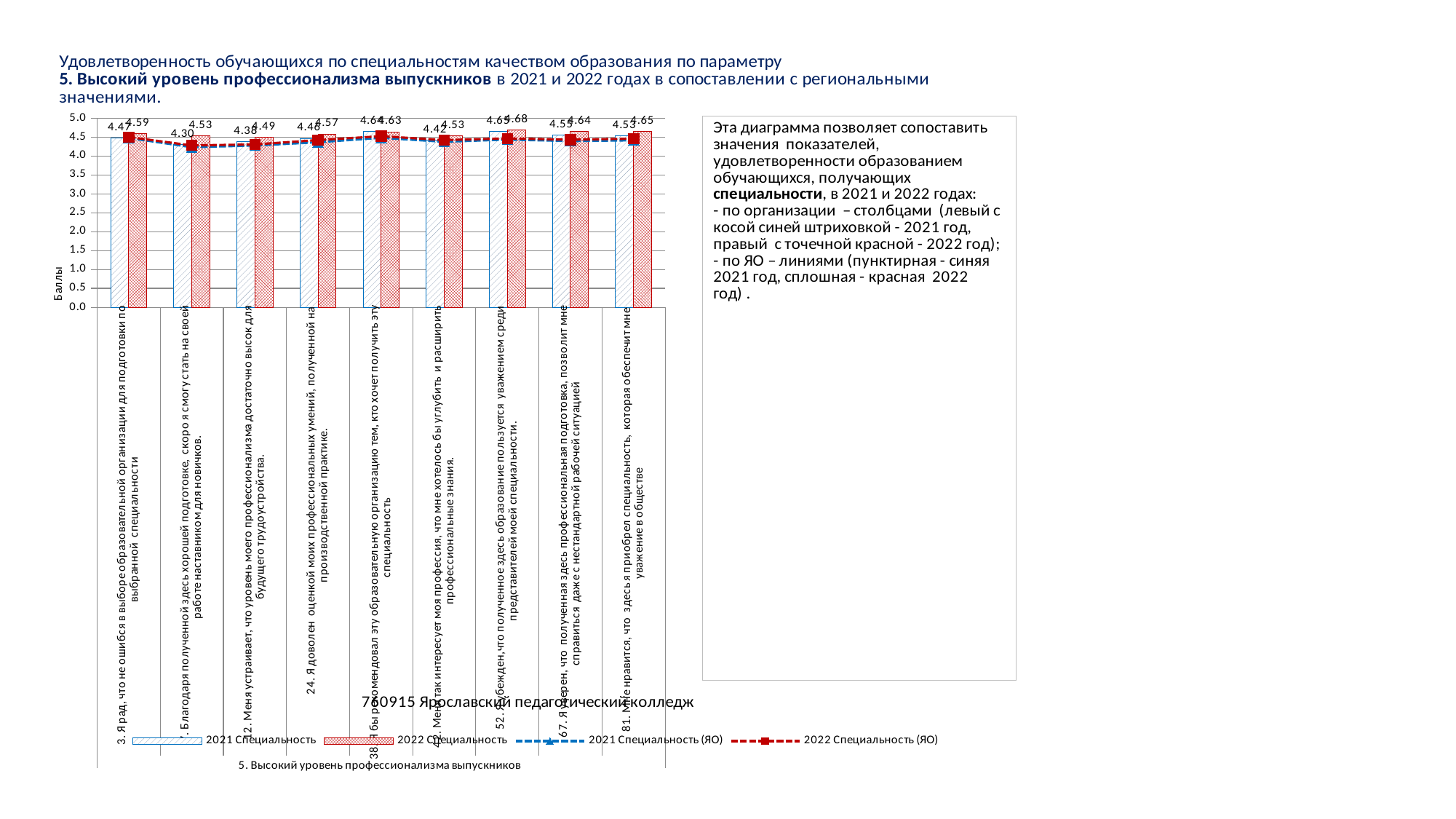
What is the 2021 Специальность value for statement 81 (Мне нравится, что здесь я приобрел специальность...)? 4.53 What is the 2022 Специальность value for statement 24 (Я доволен оценкой моих профессиональных умений...)? 4.57 Which statement has the highest 2022 Специальность value? 52. Убежден, что полученное здесь образование пользуется уважением среди представителей моей специальности (4.68) What is the 2022 Специальность value for statement 3 (Я рад, что не ошибся в выборе образовательной организации...)? 4.59 Is the 2021 Специальность value for statement 52 greater or less than 4.0? greater By how much did the Специальность value for statement 3 increase from 2021 to 2022? 0.12 How many series does the chart legend list? 4 What is the lowest value among the 2021 Специальность bars? 4.30 How many statements (categories) are shown on the x axis of the chart? 9 For statement 67 (Я уверен, что полученная здесь профессиональная подготовка...), which year has the higher Специальность value, 2021 or 2022? 2022 What is the 2021 Специальность value for statement 3 (Я рад, что не ошибся в выборе образовательной организации...)? 4.47 What is the label of the vertical axis of the chart? Баллы